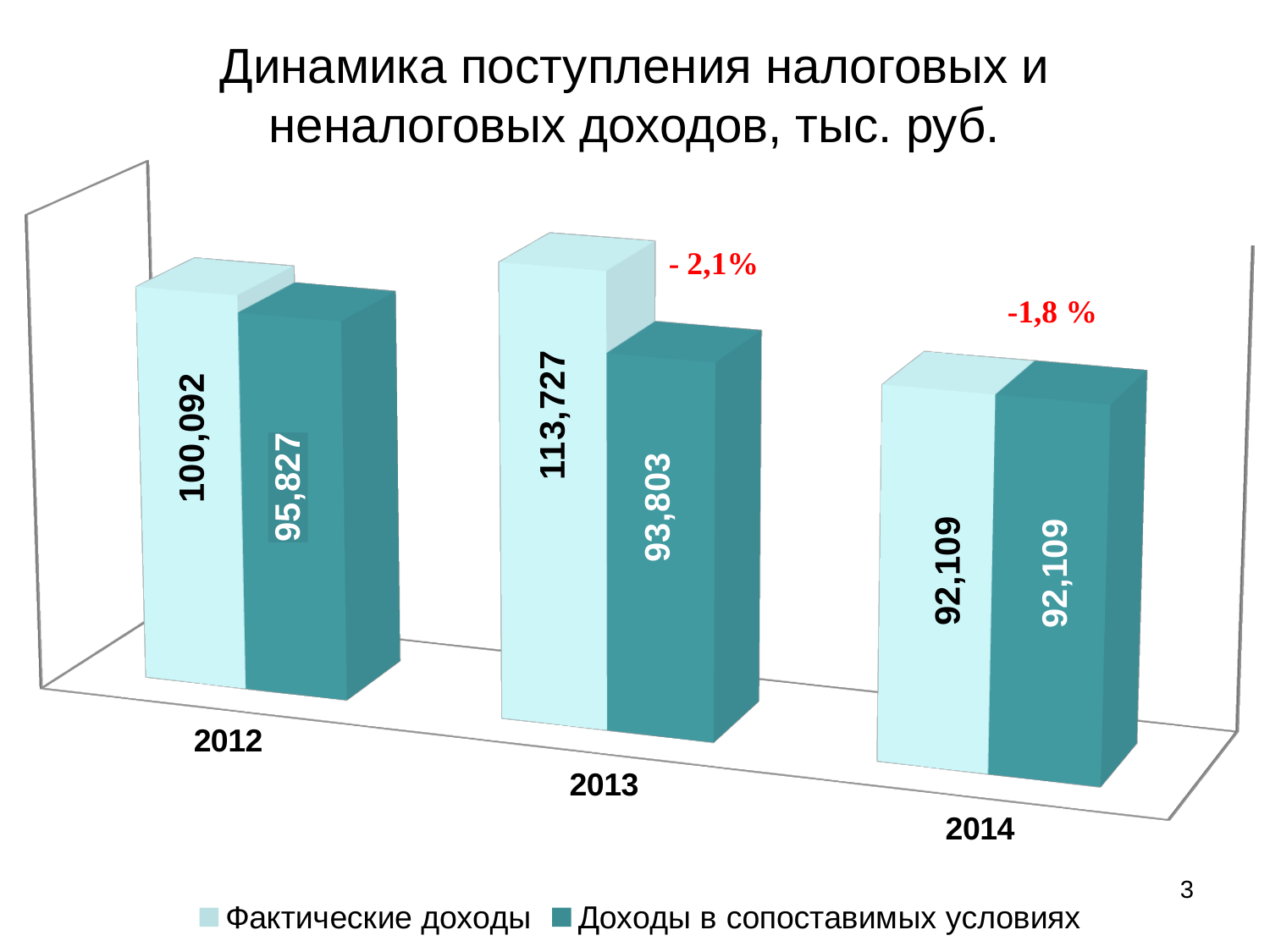
What is the value of Фактические доходы for 2014? 92,109 What kind of chart is shown on the slide? Bar chart What percentage change is annotated in red next to the 2014 bars? -1,8 % What is the value of Фактические доходы for 2012? 100,092 How many years are shown on the x axis? 3 What is the difference between Фактические доходы and Доходы в сопоставимых условиях in 2013? 19,924 How many series does the legend list? 2 What is the value of Доходы в сопоставимых условиях for 2013? 93,803 Which is larger in 2012: Фактические доходы or Доходы в сопоставимых условиях? Фактические доходы In which year is Фактические доходы highest? 2013 In which year is Доходы в сопоставимых условиях lowest? 2014 What is the difference between Фактические доходы in 2013 and in 2012? 13,635